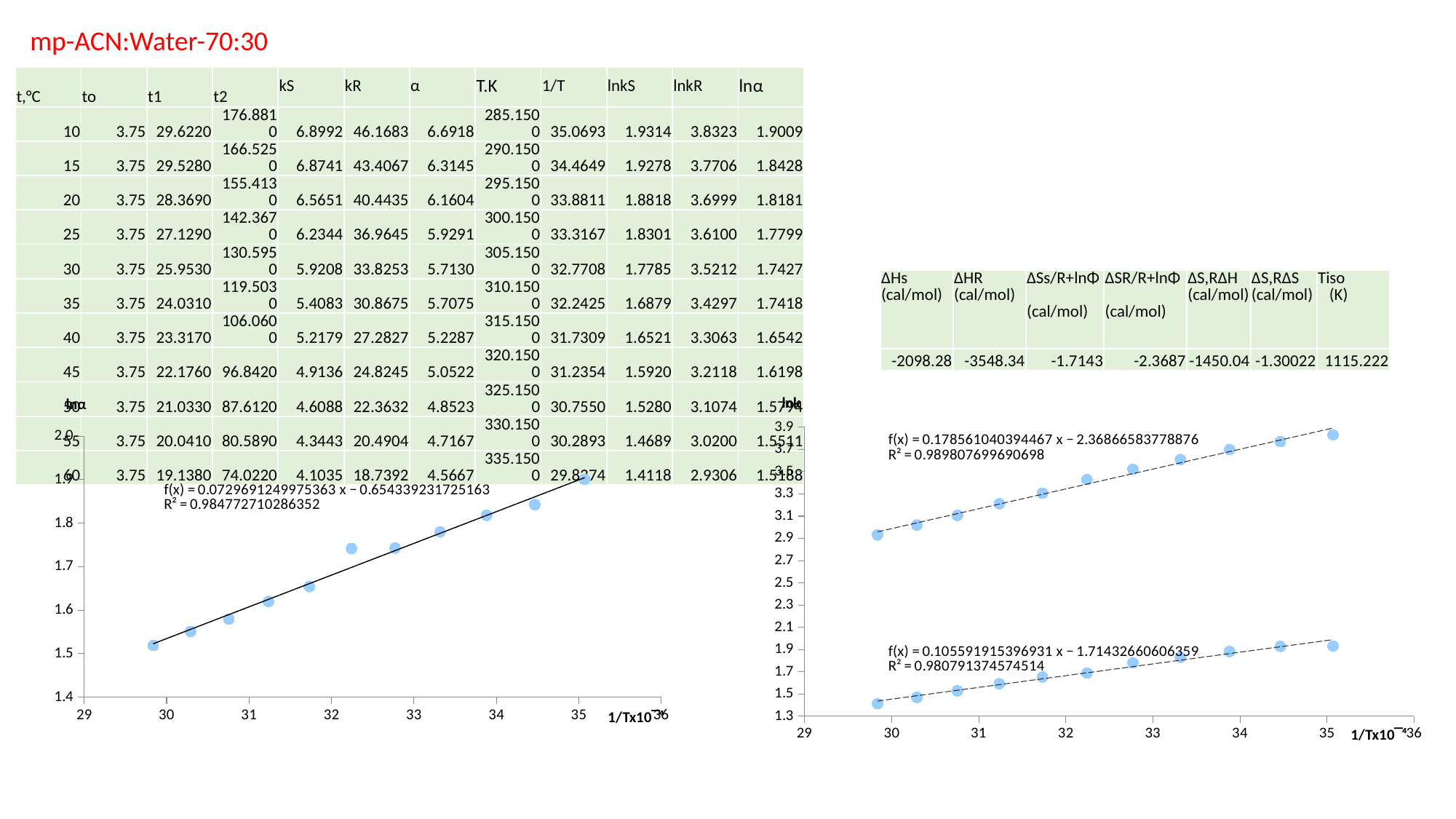
On the right chart, which series has the larger values, the upper series or the lower series? the upper series On the left chart, do the plotted values rise or fall as 1/T increases along the x axis? rise On the right chart, what R² value is printed for the upper trendline? 0.989807699690698 On the right chart, what is the intercept printed in the lower trendline equation? −1.71432660606359 What kind of chart is the chart on the left of the slide? scatter chart On the right chart, is the value of the upper series' rightmost point (near x = 35) greater or less than 3.7? greater On the left chart, is the value of the rightmost point (near x = 35) greater or less than 1.8? greater On the left chart, what is the slope printed in the trendline equation f(x)? 0.0729691249975363 On the left chart, is the value of the leftmost point (near x = 30) greater or less than 1.6? less On the right chart, how many data series are plotted? 2 On the left chart, how many data points are plotted? 11 On the left chart, what R² value is printed for the trendline? 0.984772710286352